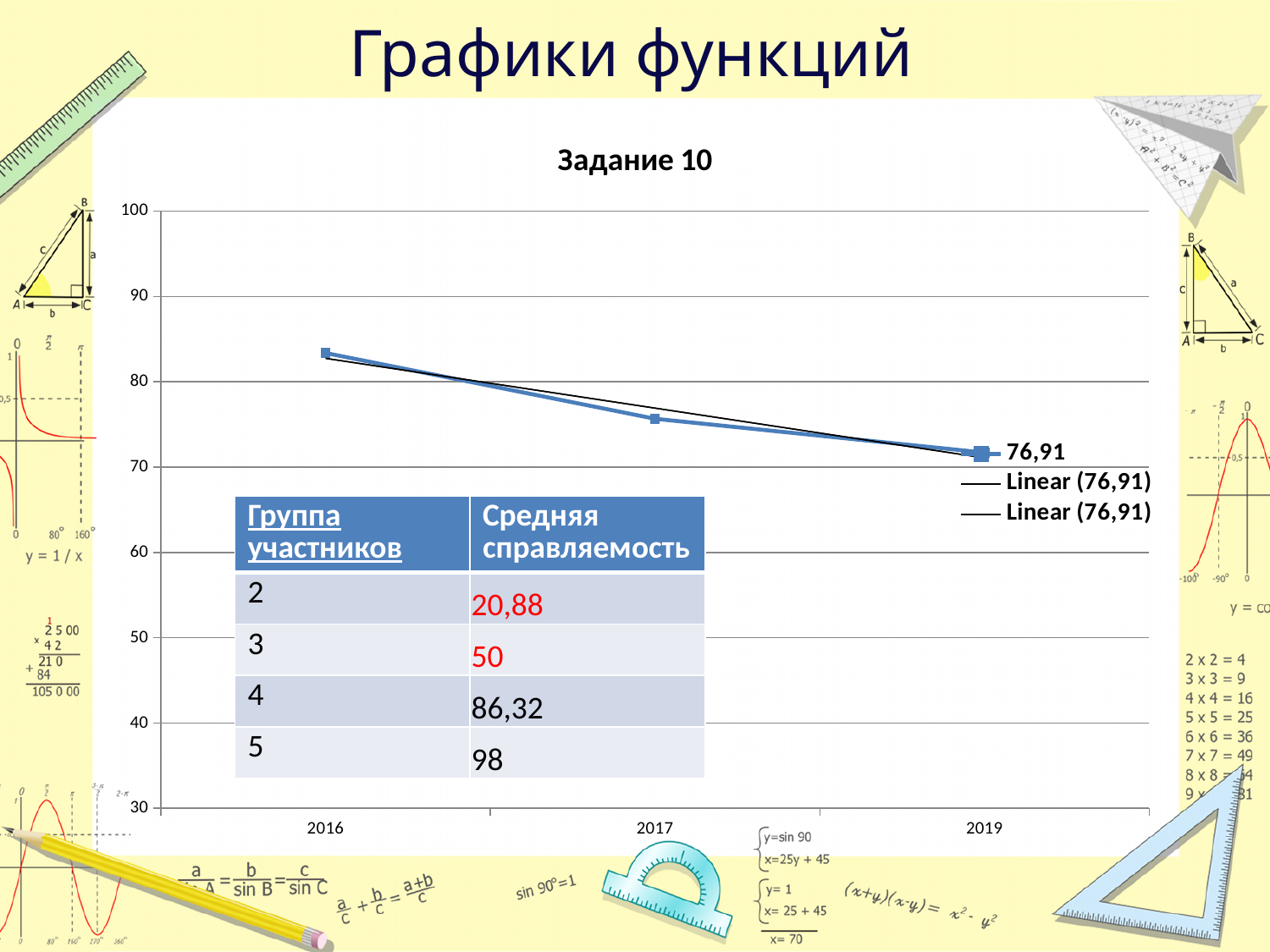
How many entries does the chart legend list? 3 Is the value for 2019 greater or less than 80? less Which year has the larger value, 2016 or 2017? 2016 Which year has the highest value on the line? 2016 Is the value for 2016 greater or less than 90? less What is the title of the chart? Задание 10 Which year has the lowest value on the line? 2019 Is the value for 2017 greater or less than 80? less What kind of chart is shown under the title "Задание 10"? line chart How many data points are plotted on the line in the chart? 3 Do the values on the line rise or fall from 2016 to 2019? fall